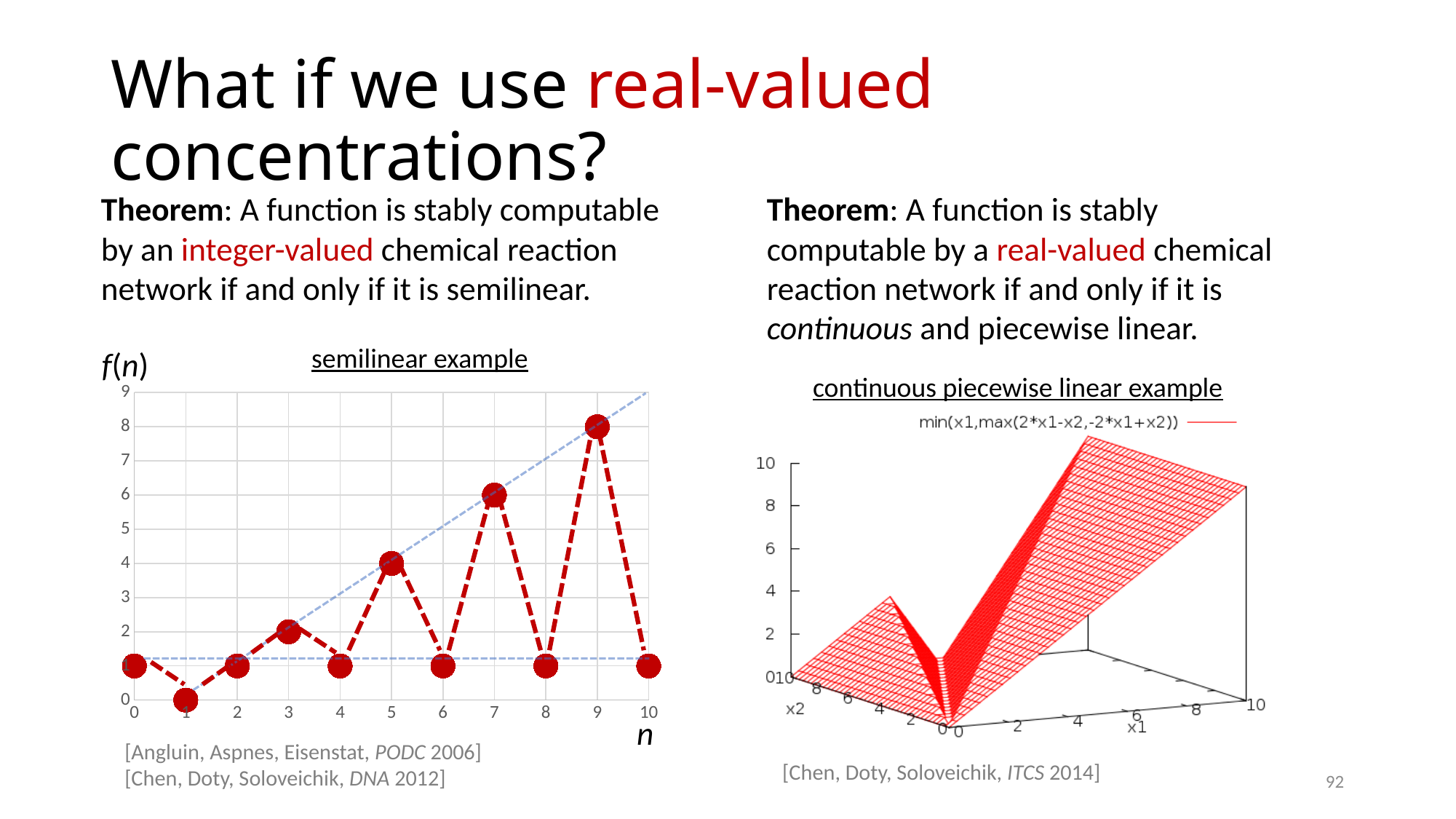
What kind of chart is the 'continuous piecewise linear example' chart? 3D surface plot In the 'continuous piecewise linear example' chart, what function is named in the legend? min(x1,max(2*x1-x2,-2*x1+x2)) What kind of chart is the 'semilinear example' chart? Line chart In the 'semilinear example' chart, which is larger, f(3) or f(5)? f(5) In the 'semilinear example' chart, at which value of n is f(n) lowest? 1 In the 'semilinear example' chart, what is the difference between f(9) and f(7)? 2 In the 'semilinear example' chart, what is the value of f(n) at n = 7? 6 In the 'semilinear example' chart, what is the value of f(n) at n = 9? 8 In the 'semilinear example' chart, what is the value of f(n) at n = 5? 4 In the 'semilinear example' chart, at which value of n is f(n) highest? 9 In the 'semilinear example' chart, how many data points are plotted? 11 In the 'semilinear example' chart, what is the value of f(n) at n = 1? 0